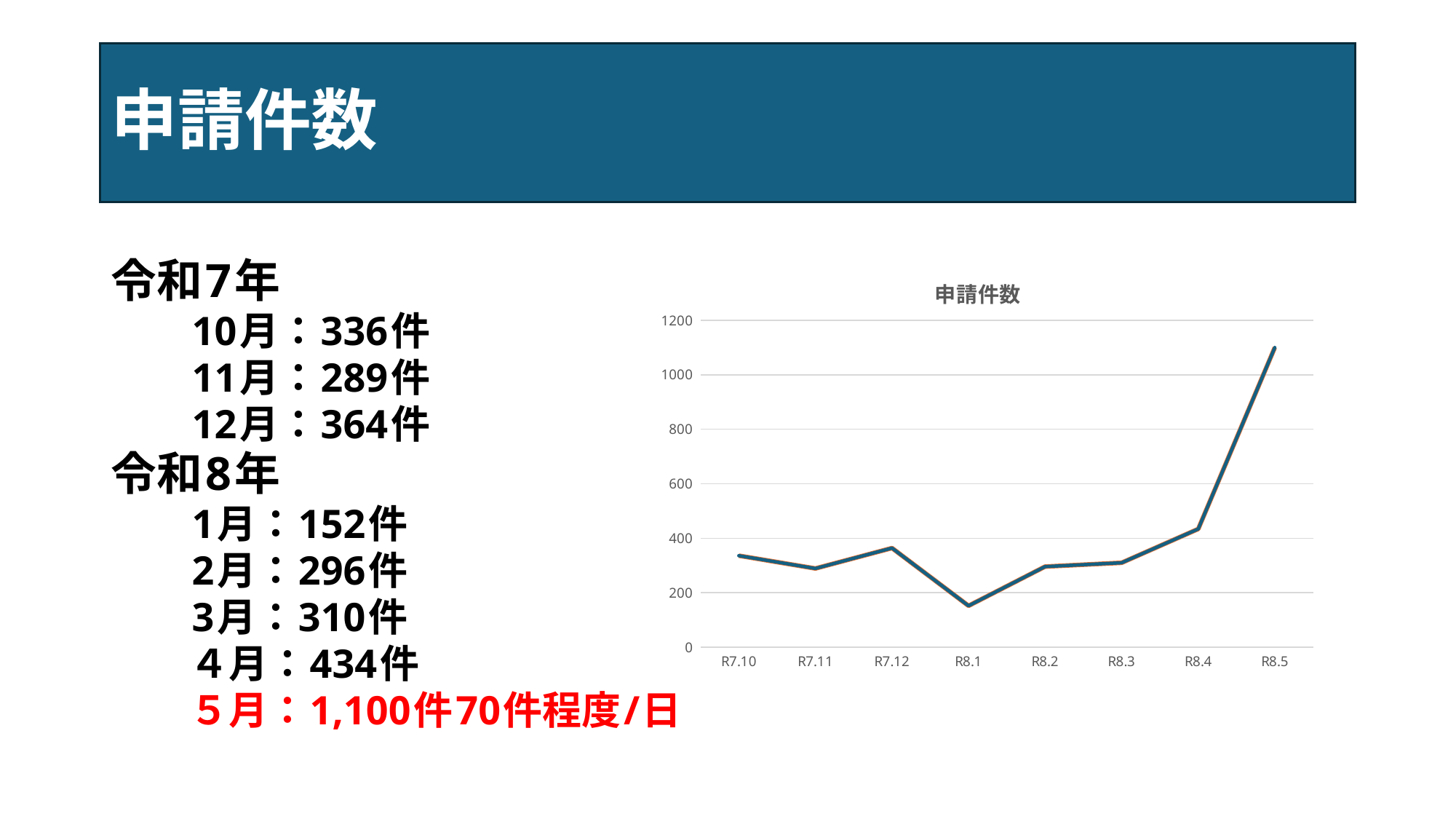
Do the values rise or fall from R8.1 to R8.5? rise Which month has the highest value in the chart? R8.5 What is the difference between the values for R8.4 (434件) and R8.3 (310件)? 124件 Which is larger, the value for R7.11 or the value for R7.12? R7.12 What kind of chart is shown on the slide? line chart Is the value for R8.5 greater or less than 1000? greater How many data points are plotted along the x axis of the chart? 8 Which month has the lowest value in the chart? R8.1 What is the title of the chart? 申請件数 Is the value for R8.1 greater or less than 200? less What is the number of applications for R7.10 (令和7年10月)? 336件 What is the number of applications for R8.4 (令和8年4月)? 434件